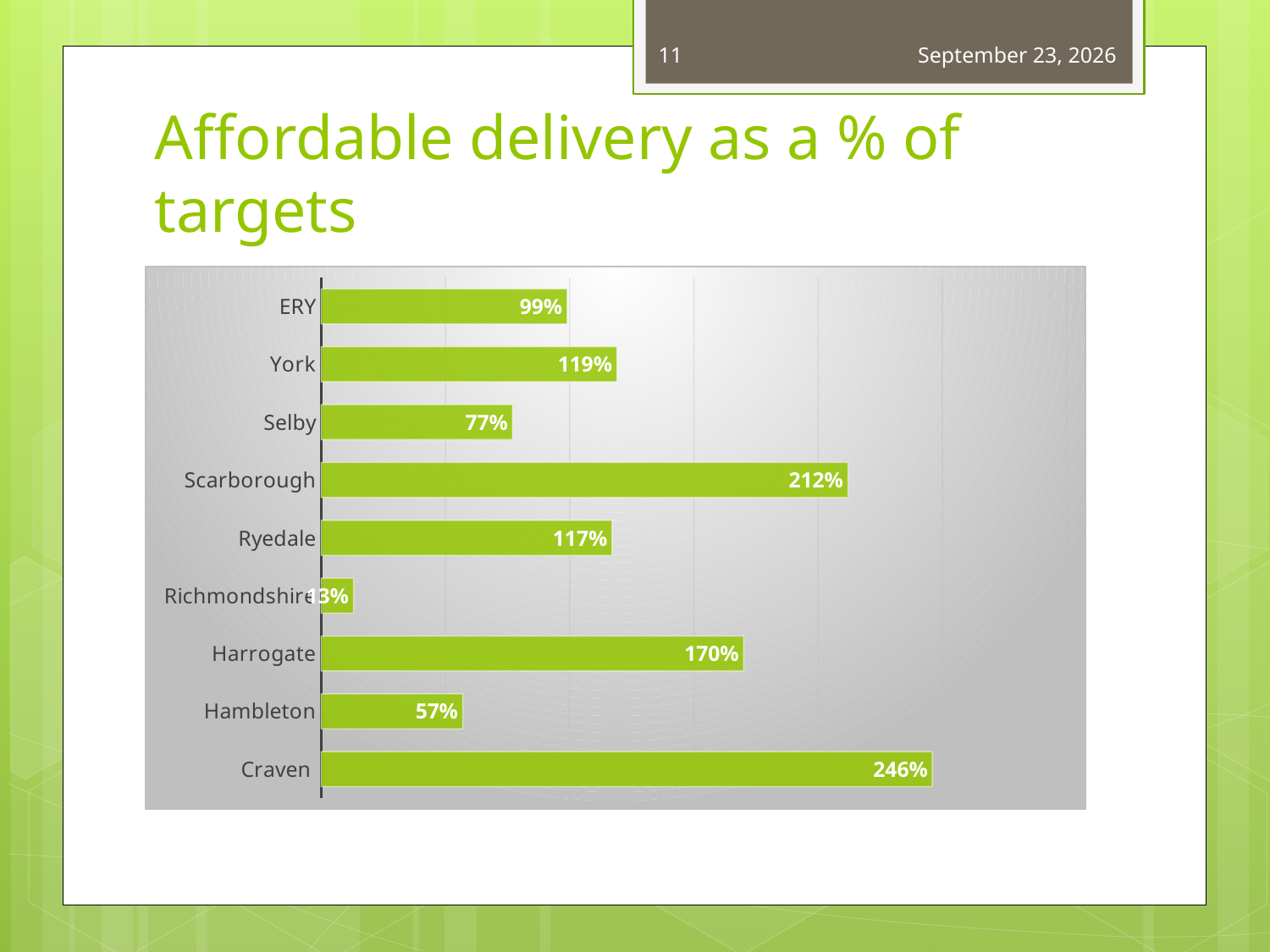
What is the difference between the values for Craven and Scarborough? 34% What is the value for York? 119% What is the value for Hambleton? 57% Which category has the lowest value? Richmondshire What is the value for Craven? 246% What is the value for Scarborough? 212% What kind of chart is shown on the slide? Bar chart Which category has the highest value? Craven What is the title of the slide containing the chart? Affordable delivery as a % of targets How many categories are shown in the chart? 9 Which is larger, the value for York or the value for Ryedale? York What is the difference between the values for Harrogate and Hambleton? 113%